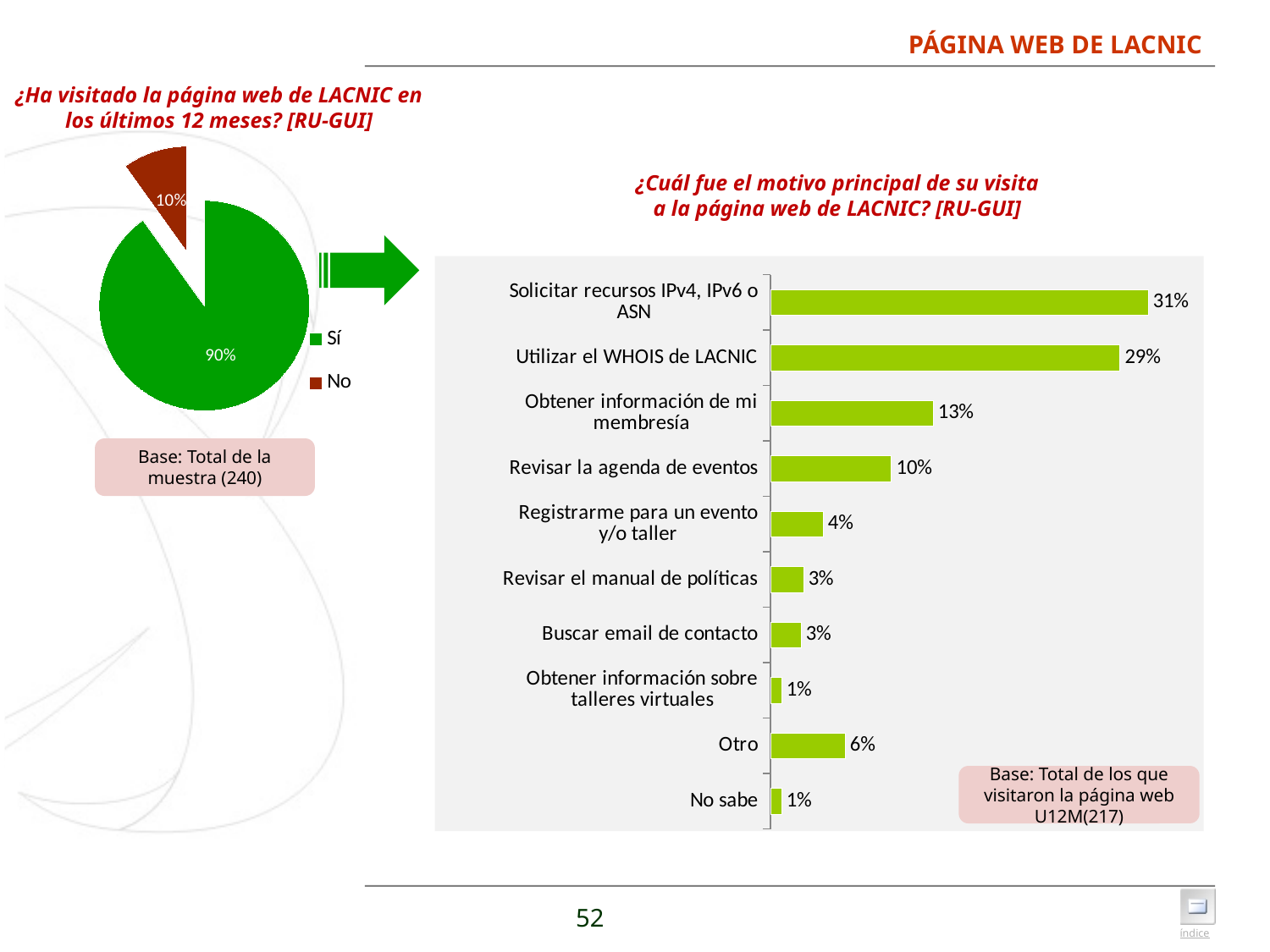
In the bar chart on the right, what is the value for 'Registrarme para un evento y/o taller'? 4% In the pie chart on the left, what share of respondents answered 'Sí'? 90% In the bar chart on the right, what is the value for 'Utilizar el WHOIS de LACNIC'? 29% In the bar chart on the right, how many categories are shown? 10 In the bar chart on the right, which category has the highest value? Solicitar recursos IPv4, IPv6 o ASN In the bar chart on the right, what is the difference between 'Solicitar recursos IPv4, IPv6 o ASN' and 'Utilizar el WHOIS de LACNIC'? 2% In the bar chart on the right, which is larger: 'Obtener información de mi membresía' or 'Otro'? Obtener información de mi membresía What is the base noted for the bar chart on the right? Total de los que visitaron la página web U12M(217) In the pie chart on the left, what share of respondents answered 'No'? 10% In the bar chart on the right, what is the value for 'Revisar la agenda de eventos'? 10% In the pie chart on the left, how many entries does the legend list? 2 What kind of chart is the chart on the right? Bar chart